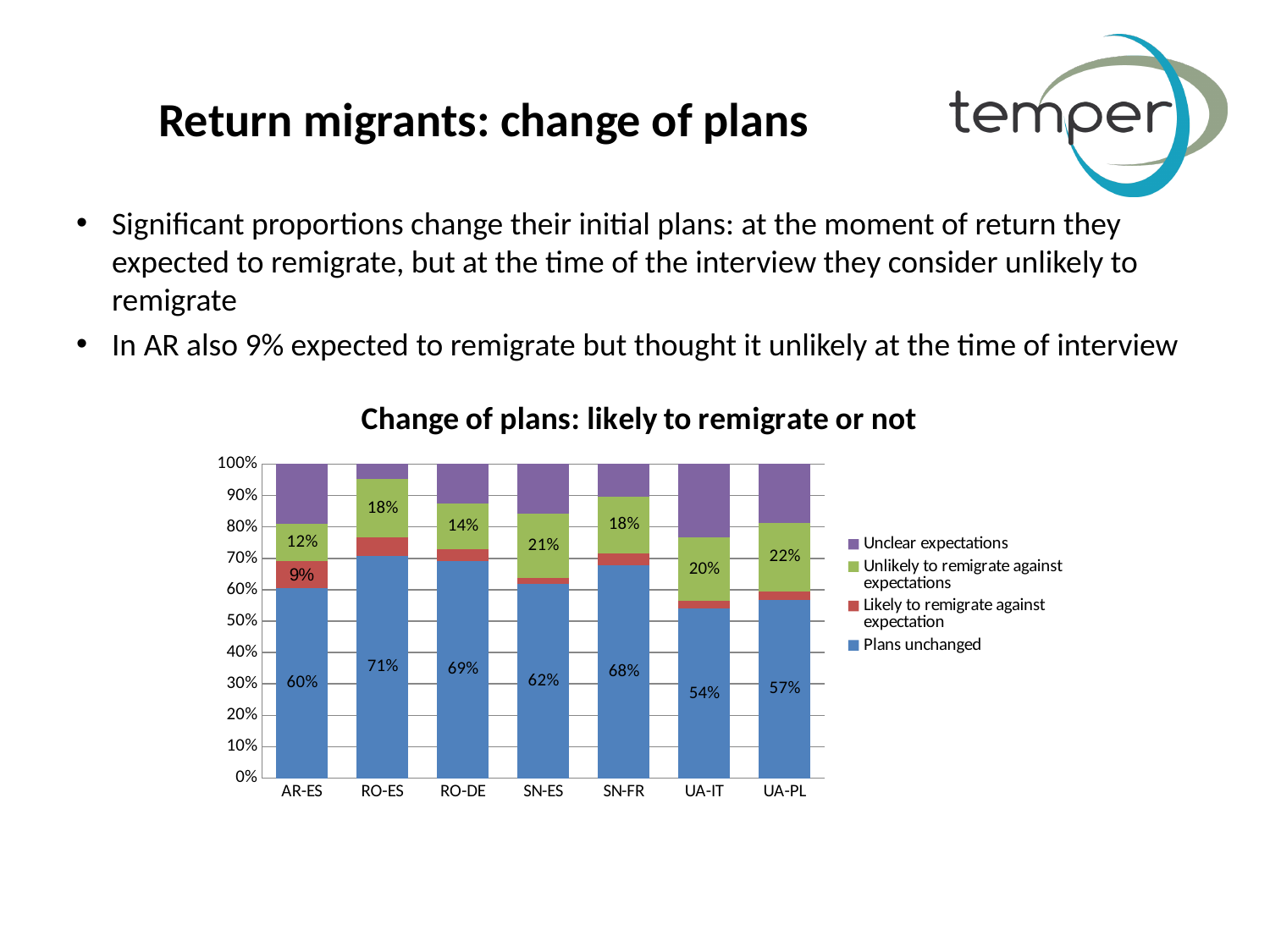
What is the value of "Likely to remigrate against expectation" for AR-ES? 9% What kind of chart is shown on the slide? Stacked bar chart Which category has the lowest value for "Unlikely to remigrate against expectations"? AR-ES What is the value of "Plans unchanged" for RO-ES? 71% Which is larger, the "Plans unchanged" value for SN-ES or for SN-FR? SN-FR What is the value of "Unlikely to remigrate against expectations" for UA-PL? 22% How many series does the legend list? 4 Which category has the lowest value for "Plans unchanged"? UA-IT How many categories are shown on the x axis? 7 What is the title of the chart? Change of plans: likely to remigrate or not What is the difference between the "Plans unchanged" values for RO-ES and UA-IT? 17% Which category has the highest value for "Plans unchanged"? RO-ES